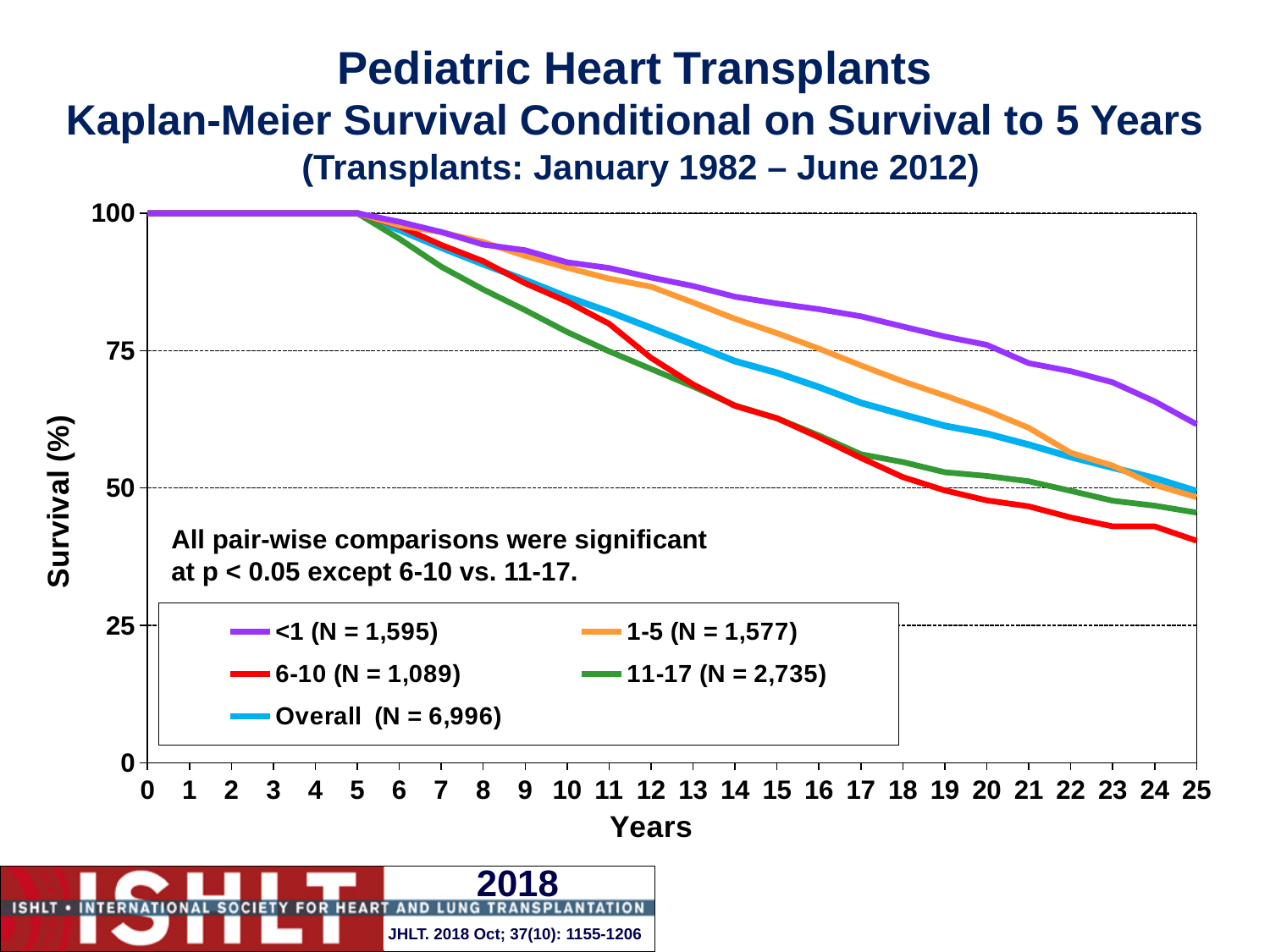
Is the survival value for the <1 series at year 25 greater or less than 50? greater According to the legend, what is the N for the Overall series? 6,996 Is the survival value for the 6-10 series at year 25 greater or less than 50? less Which series has the lowest survival at year 25? 6-10 (N = 1,089) Is the survival value for the <1 series at year 15 greater or less than 75? greater At year 20, which series has higher survival: <1 or 11-17? <1 How many series does the legend list? 5 What is the survival value for the Overall series at year 5? 100 What kind of chart is shown on the slide? line chart Do the survival curves rise or fall as the years increase beyond year 5? fall Which series has the highest survival at year 25? <1 (N = 1,595)